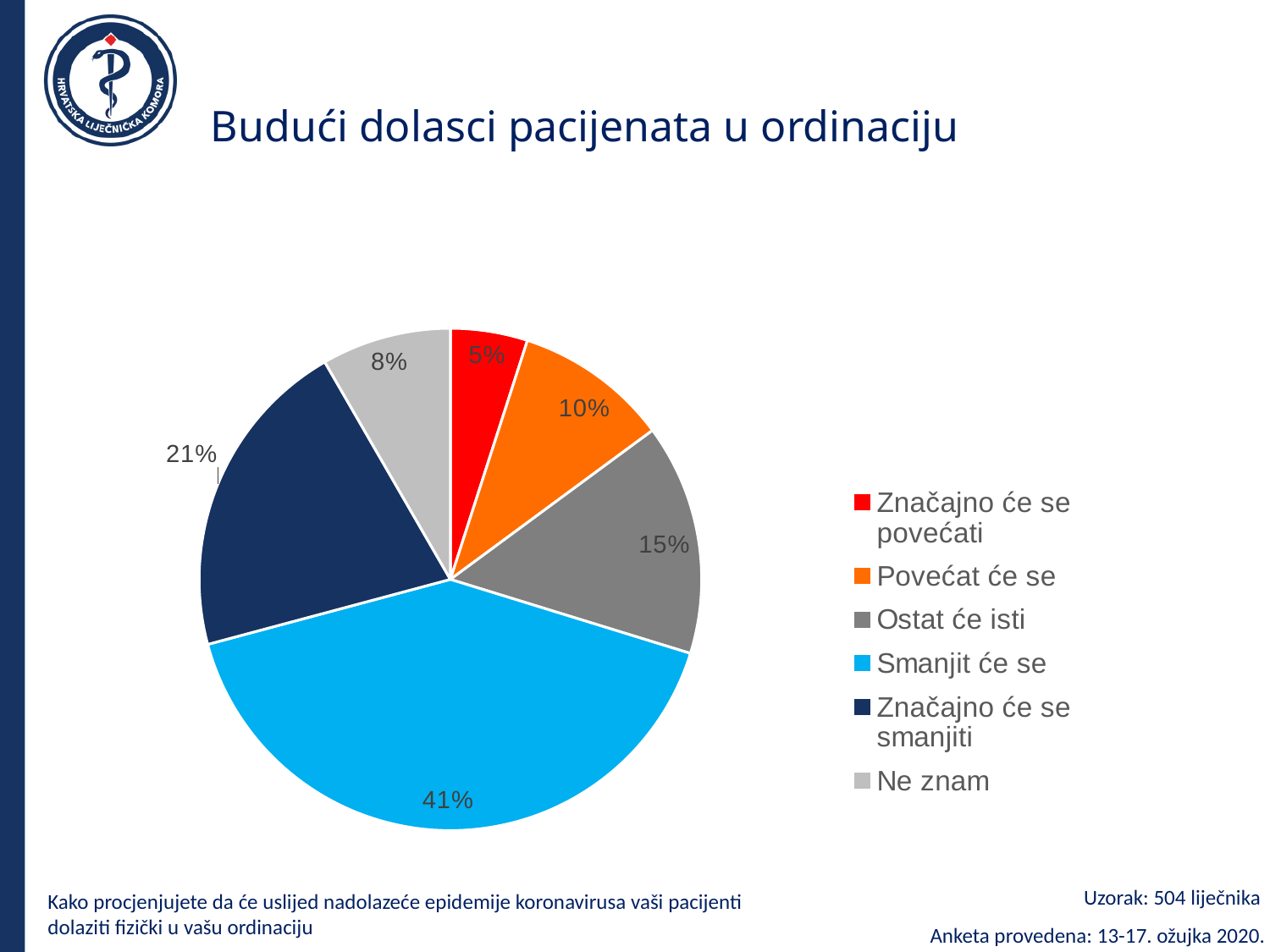
What is the value for "Povećat će se"? 10% What is the value for "Ostat će isti"? 15% Which is larger, "Ostat će isti" or "Povećat će se"? Ostat će isti What share of the pie does "Značajno će se smanjiti" have? 21% What share of the pie does "Smanjit će se" have? 41% What is the value for "Ne znam"? 8% Which category has the largest slice? Smanjit će se How many categories does the pie chart have? 6 What is the title of the chart? Budući dolasci pacijenata u ordinaciju What kind of chart is shown on the slide? pie chart Which category has the smallest slice? Značajno će se povećati What is the difference between the values for "Smanjit će se" and "Značajno će se smanjiti"? 20%